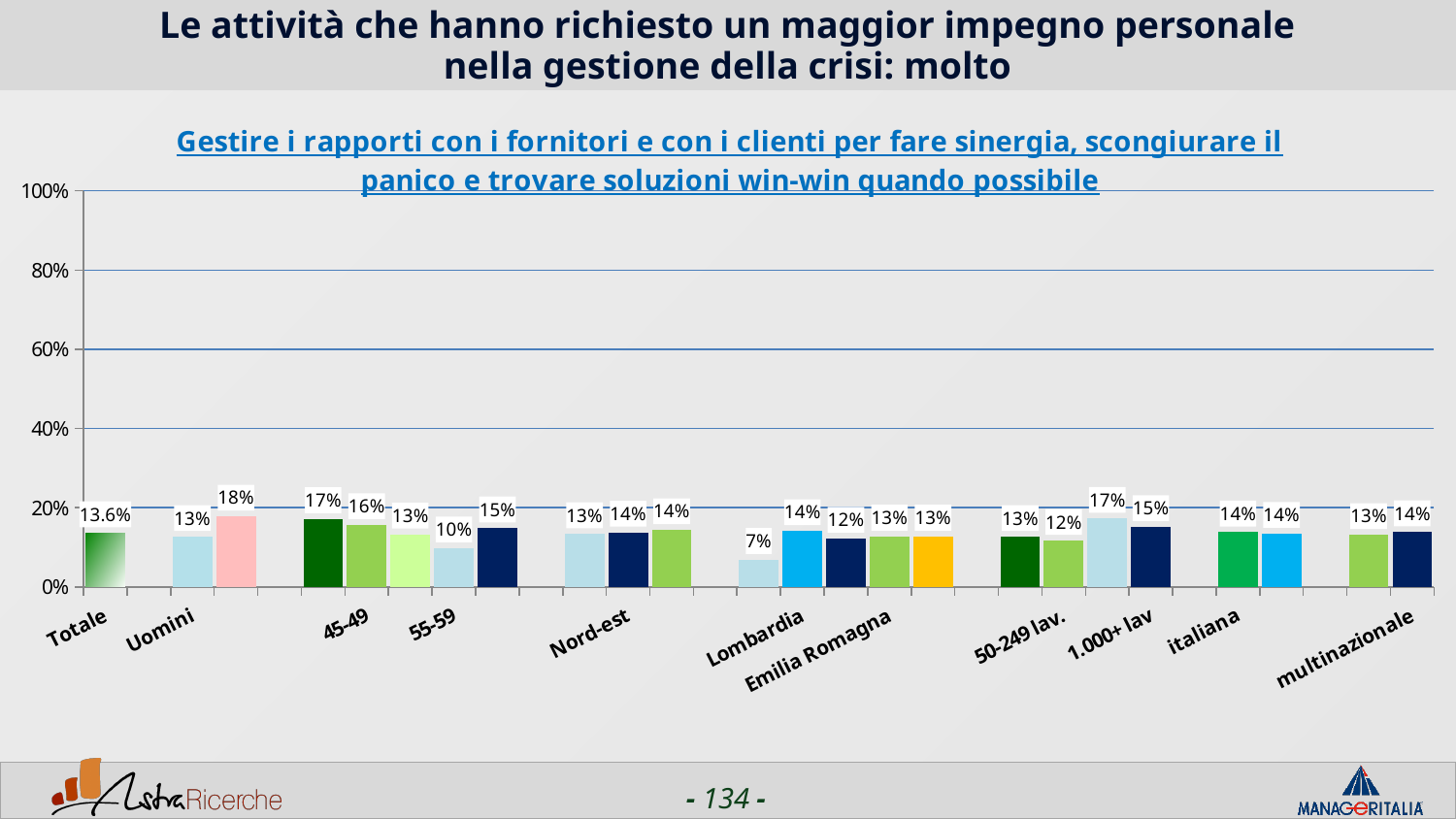
What is the lowest value labelled on any bar in the chart? 7% Are any bars in the chart above the 20% gridline? No What is the value for Uomini? 13% What kind of chart is shown on the slide? bar chart What is the difference between the value for Totale and the value for Uomini? 0.6 percentage points Which is larger, the value for Totale or the value for Uomini? Totale What is the highest value shown on the y axis? 100% What is the highest value labelled on any bar in the chart? 18% What is the title of the chart? Gestire i rapporti con i fornitori e con i clienti per fare sinergia, scongiurare il panico e trovare soluzioni win-win quando possibile Is the value for Totale greater or less than 20%? less What is the value for Totale? 13.6% How many bars are plotted in the chart? 24